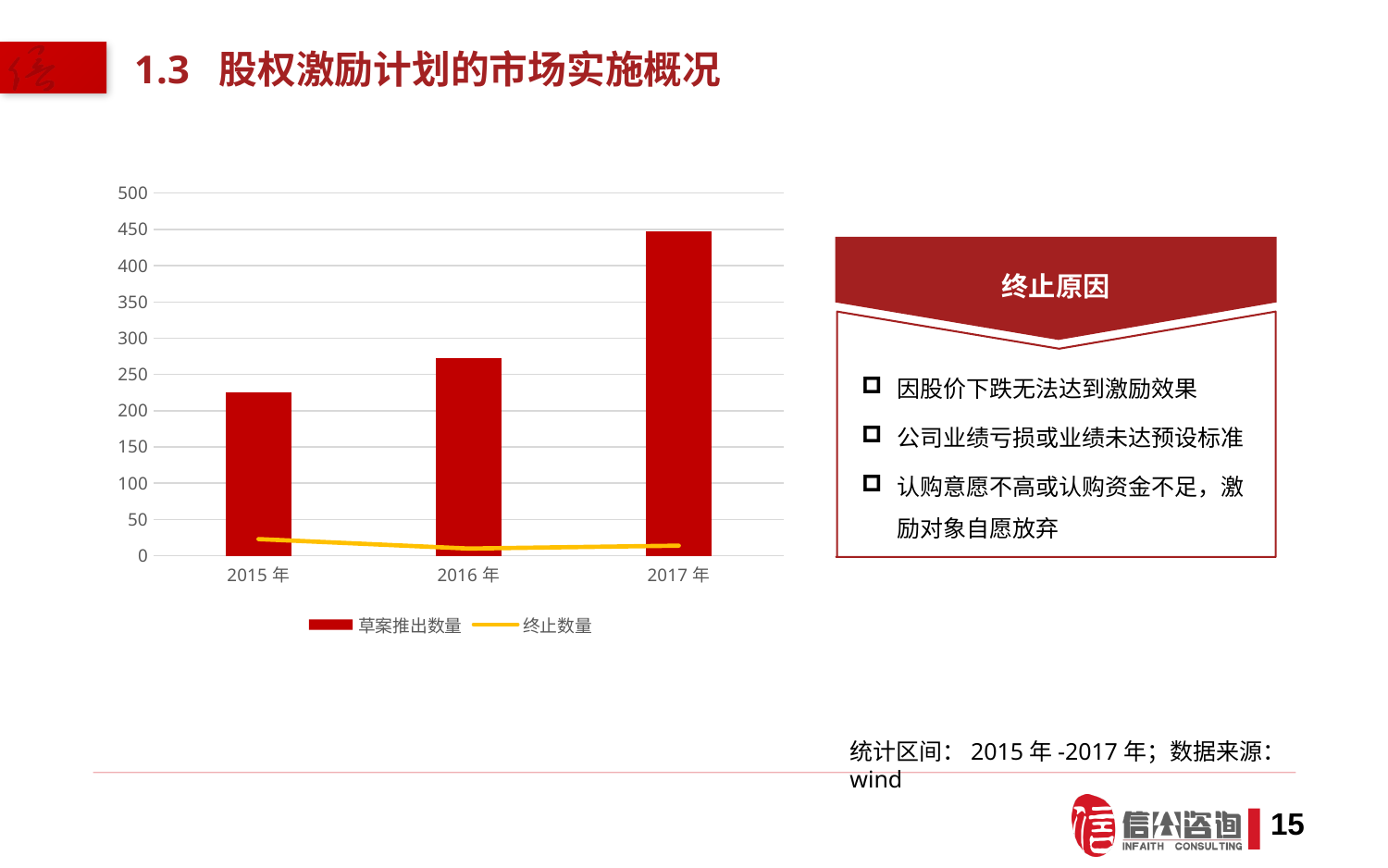
Which year has the lowest value for 草案推出数量? 2015 年 What colour is used for the 终止数量 line in the chart? yellow Which is larger, 草案推出数量 in 2016 年 or in 2017 年? 2017 年 What kind of chart is shown on the slide? bar chart with a line Which year has the highest value for 草案推出数量? 2017 年 How many categories are shown on the x axis of the chart? 3 Is the value for 草案推出数量 in 2016 年 greater or less than 250? greater Is the value for 终止数量 in 2016 年 greater or less than 50? less Is the value for 草案推出数量 in 2015 年 greater or less than 250? less Do the values for 草案推出数量 rise or fall from 2015 年 to 2017 年? rise How many series does the chart legend list? 2